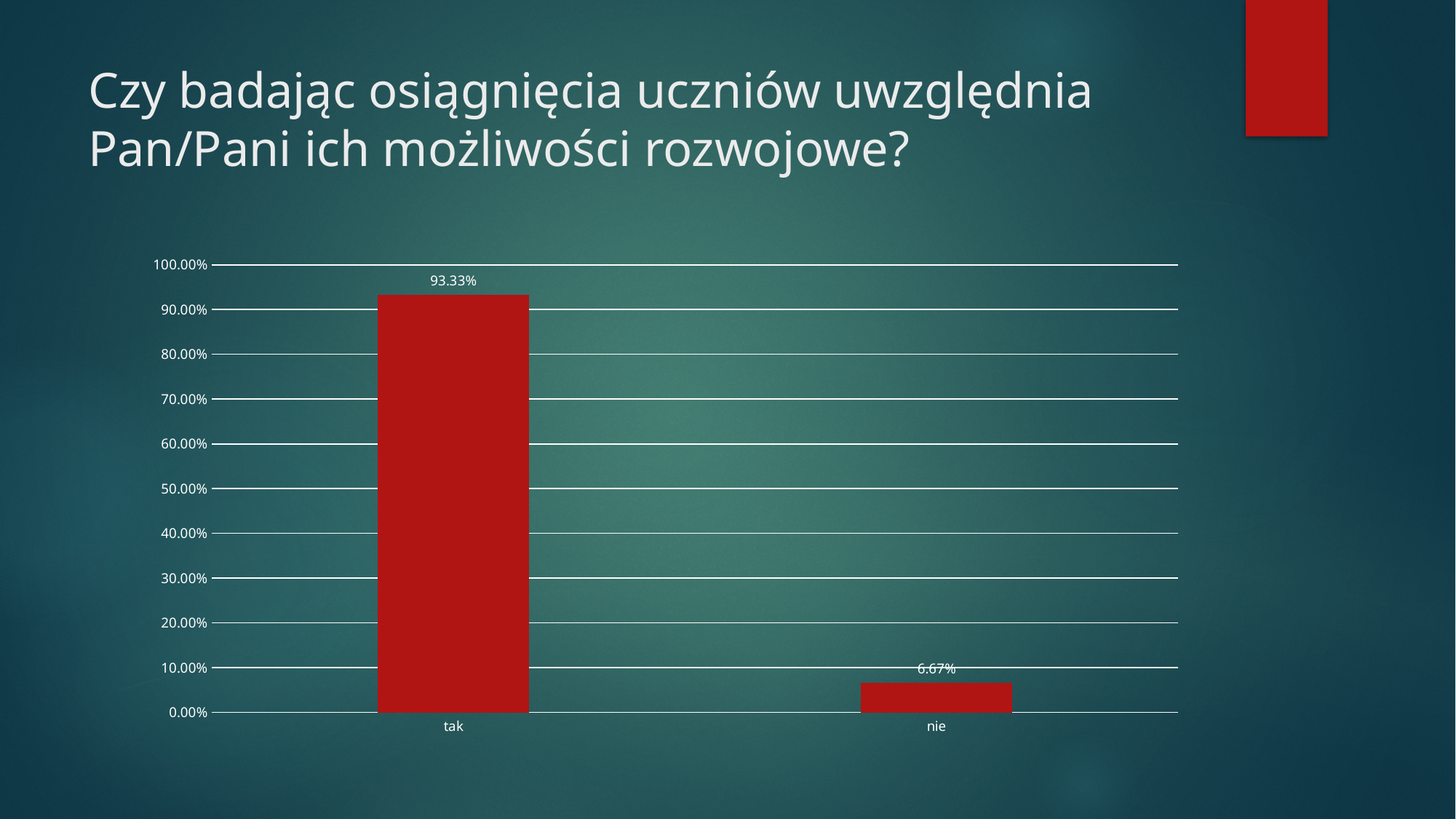
What kind of chart is shown on the slide? bar chart Which category has the lowest value? nie What is the value for "nie"? 6.67% Is the value for "tak" greater or less than 90.00%? greater What colour are the bars in the chart? red What is the maximum value shown on the vertical axis? 100.00% How many categories are shown on the x axis? 2 Is the value for "nie" greater or less than 10.00%? less What is the value for "tak"? 93.33% What is the difference between the values for "tak" and "nie"? 86.66% Which category has the highest value? tak Which is larger, the value for "tak" or the value for "nie"? tak